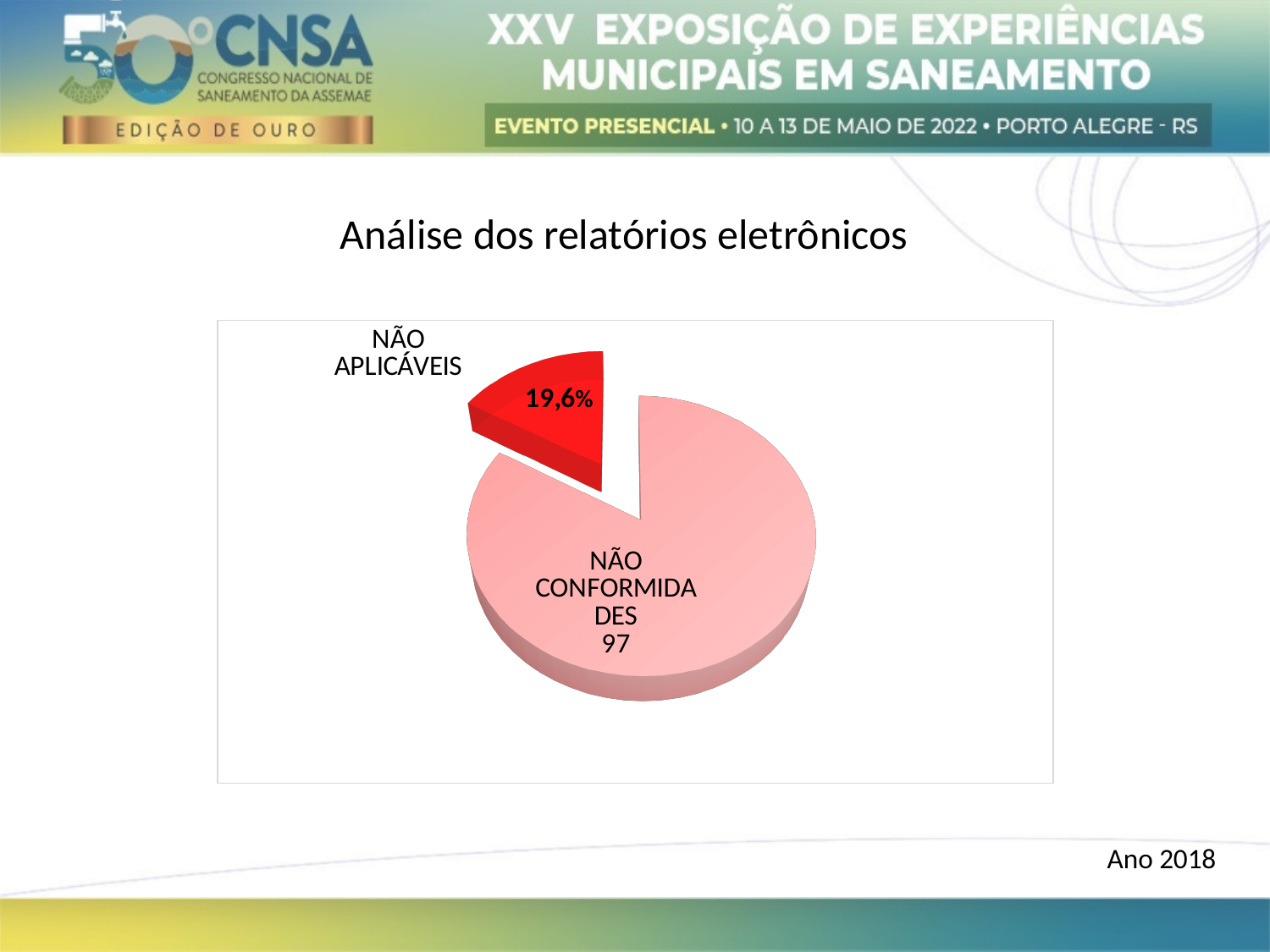
What share of the pie does the NÃO APLICÁVEIS slice represent? 19,6% Which slice is larger, NÃO APLICÁVEIS or NÃO CONFORMIDADES? NÃO CONFORMIDADES What kind of chart is shown on the slide? pie chart What colour is the NÃO APLICÁVEIS slice? red How many slices does the pie chart have? 2 Which slice of the pie chart is the smallest? NÃO APLICÁVEIS What value is printed on the NÃO APLICÁVEIS slice? 19,6% Which slice of the pie chart is the largest? NÃO CONFORMIDADES What value is printed on the NÃO CONFORMIDADES slice? 97 What is the title shown above the chart? Análise dos relatórios eletrônicos